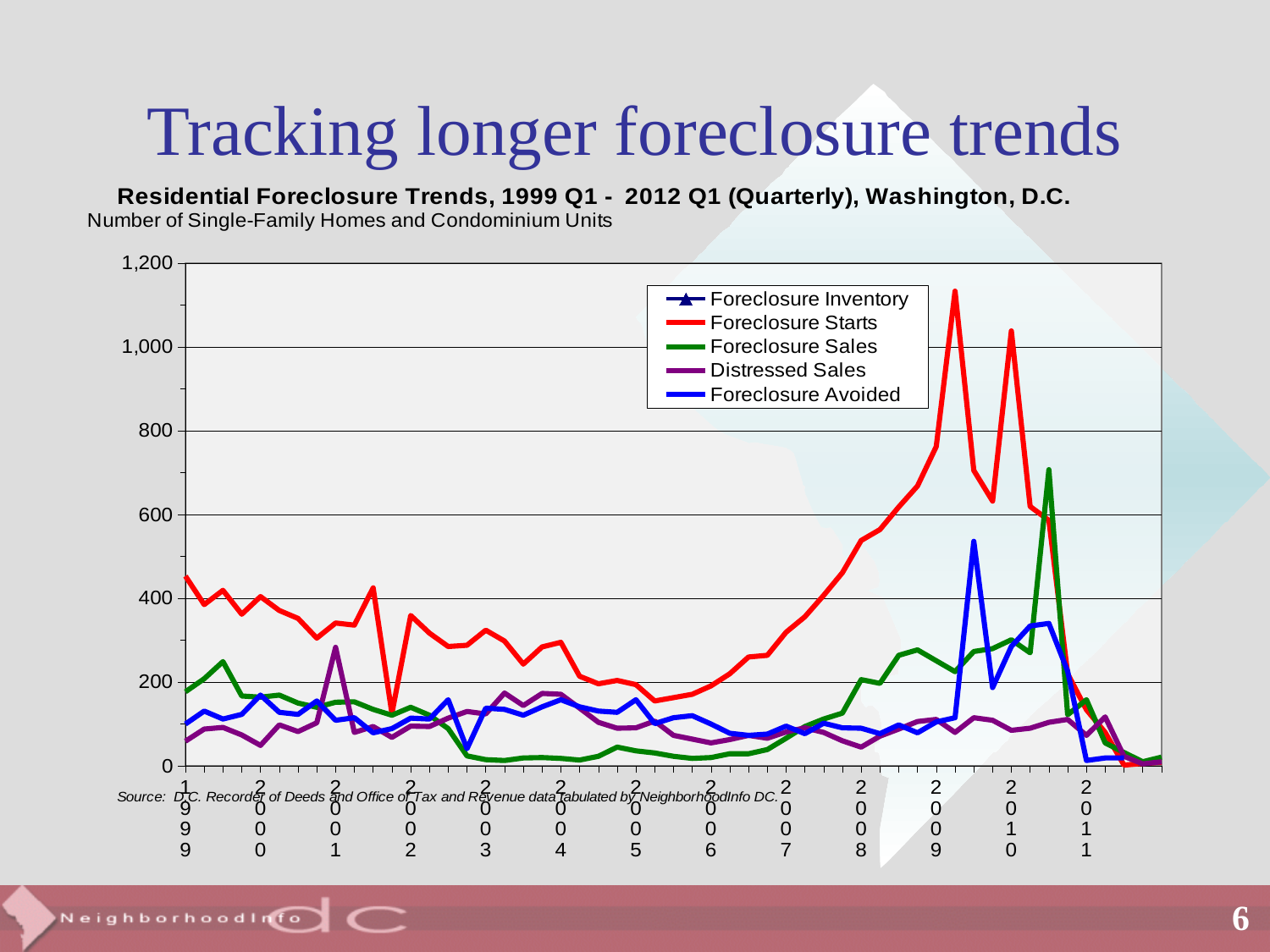
Do Foreclosure Starts generally rise or fall between 1999 and 2004? fall What kind of chart is shown on the slide? line chart Do Foreclosure Starts generally rise or fall between 2005 and 2009? rise Is the peak value of Foreclosure Avoided greater or less than 400? greater Is the peak value of Distressed Sales greater or less than 400? less Is the peak value of Foreclosure Starts greater or less than 1,000? greater How many series does the legend list? 5 Which series reaches the highest value on the chart? Foreclosure Starts What is the title of the chart? Residential Foreclosure Trends, 1999 Q1 - 2012 Q1 (Quarterly), Washington, D.C. In 2010, which series is higher: Foreclosure Starts or Distressed Sales? Foreclosure Starts